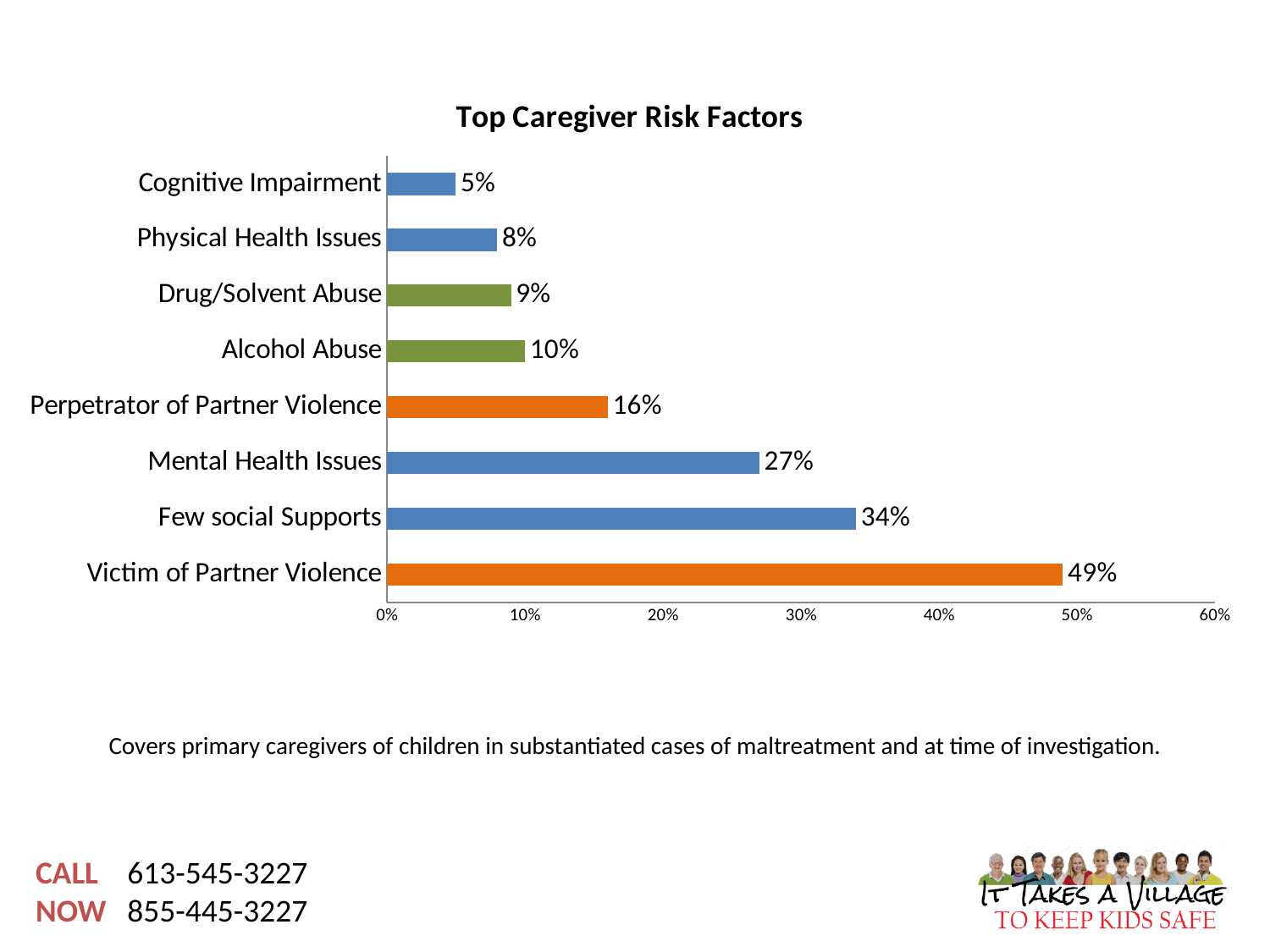
How many risk factors are shown in the chart? 8 Is the value for Few social Supports greater or less than 30%? greater What kind of chart is shown on the slide? bar chart What is the difference between Victim of Partner Violence and Perpetrator of Partner Violence? 33% Which risk factor has the highest value? Victim of Partner Violence What is the value for Alcohol Abuse? 10% What is the value for Victim of Partner Violence? 49% Which risk factor has the lowest value? Cognitive Impairment What is the title of the chart? Top Caregiver Risk Factors What is the value for Mental Health Issues? 27% Which is larger, Physical Health Issues or Drug/Solvent Abuse? Drug/Solvent Abuse What is the difference between Few social Supports and Mental Health Issues? 7%